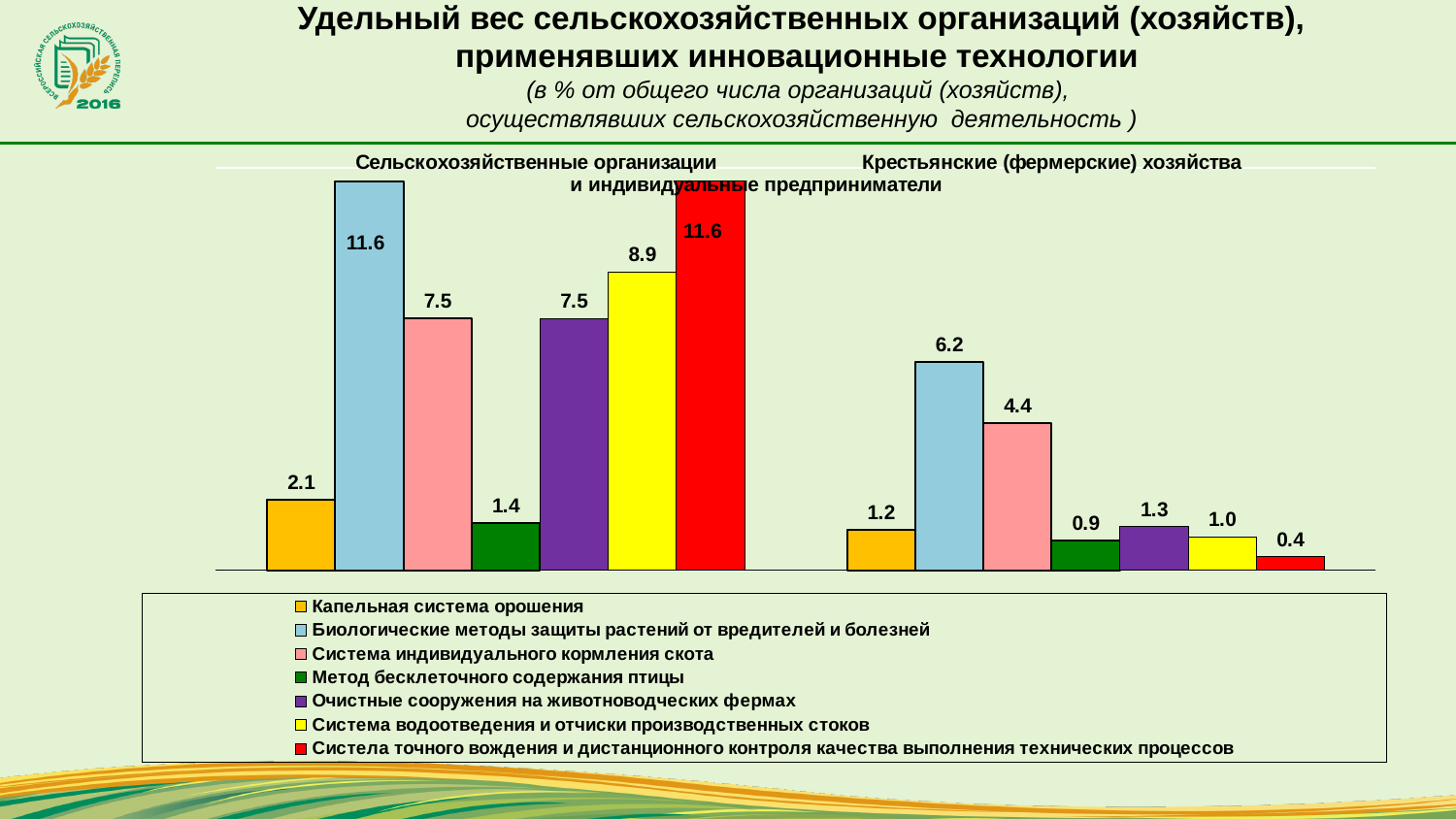
Which is larger: Очистные сооружения на животноводческих фермах for Сельскохозяйственные организации or for Крестьянские (фермерские) хозяйства и индивидуальные предприниматели? Сельскохозяйственные организации Which technology has the lowest value in the Сельскохозяйственные организации group? Метод бесклеточного содержания птицы Which technology has the highest value in the Крестьянские (фермерские) хозяйства и индивидуальные предприниматели group? Биологические методы защиты растений от вредителей и болезней What is the value for Капельная система орошения in the Сельскохозяйственные организации group? 2.1 What kind of chart is shown on the slide? Bar chart Which technology has the lowest value in the Крестьянские (фермерские) хозяйства и индивидуальные предприниматели group? Систела точного вождения и дистанционного контроля качества выполнения технических процессов What colour represents Метод бесклеточного содержания птицы in the legend? Green What is the value for Систела точного вождения и дистанционного контроля качества выполнения технических процессов in the Крестьянские (фермерские) хозяйства и индивидуальные предприниматели group? 0.4 What is the difference between the Система индивидуального кормления скота values for Сельскохозяйственные организации and Крестьянские (фермерские) хозяйства и индивидуальные предприниматели? 3.1 What is the value for Система водоотведения и отчиски производственных стоков in the Сельскохозяйственные организации group? 8.9 How many series does the legend list? 7 What is the value for Биологические методы защиты растений от вредителей и болезней in the Крестьянские (фермерские) хозяйства и индивидуальные предприниматели group? 6.2